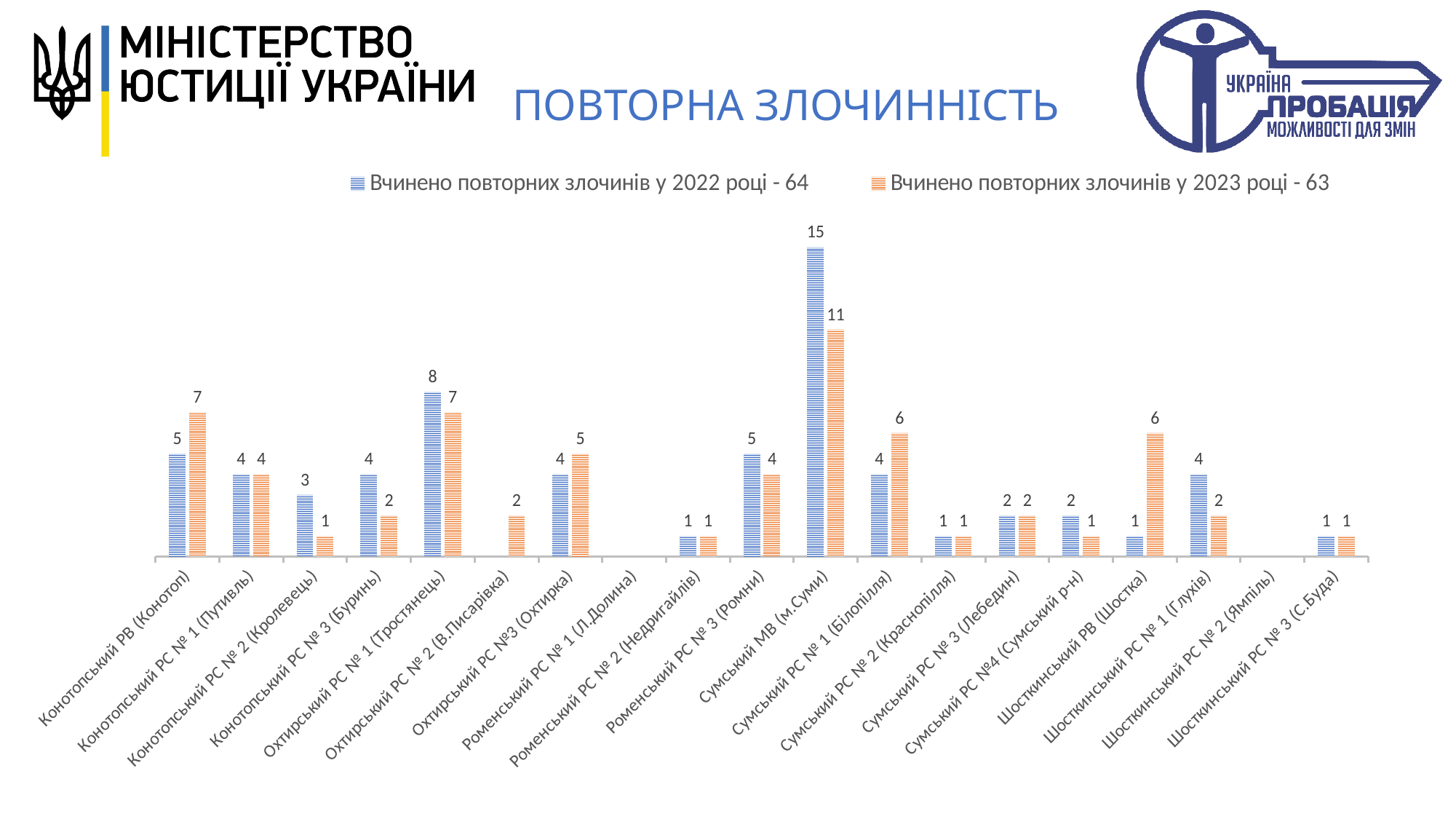
What is the value for Шосткинський РВ (Шостка) in the 2023 series? 6 What is the difference between the 2023 and 2022 values for Шосткинський РВ (Шостка)? 5 What type of chart is shown on the slide? bar chart What is the value for Сумський МВ (м.Суми) in the 2022 series? 15 Which category has the highest value in the 2023 series? Сумський МВ (м.Суми) How many categories are shown on the x axis? 19 How many series does the legend list? 2 What is the difference between the 2022 and 2023 values for Сумський МВ (м.Суми)? 4 What is the value for Охтирський РС № 1 (Тростянець) in the 2022 series? 8 What is the title of the chart? ПОВТОРНА ЗЛОЧИННІСТЬ Which is larger for Конотопський РВ (Конотоп): the 2022 value or the 2023 value? 2023 value What is the value for Сумський РС № 1 (Білопілля) in the 2023 series? 6